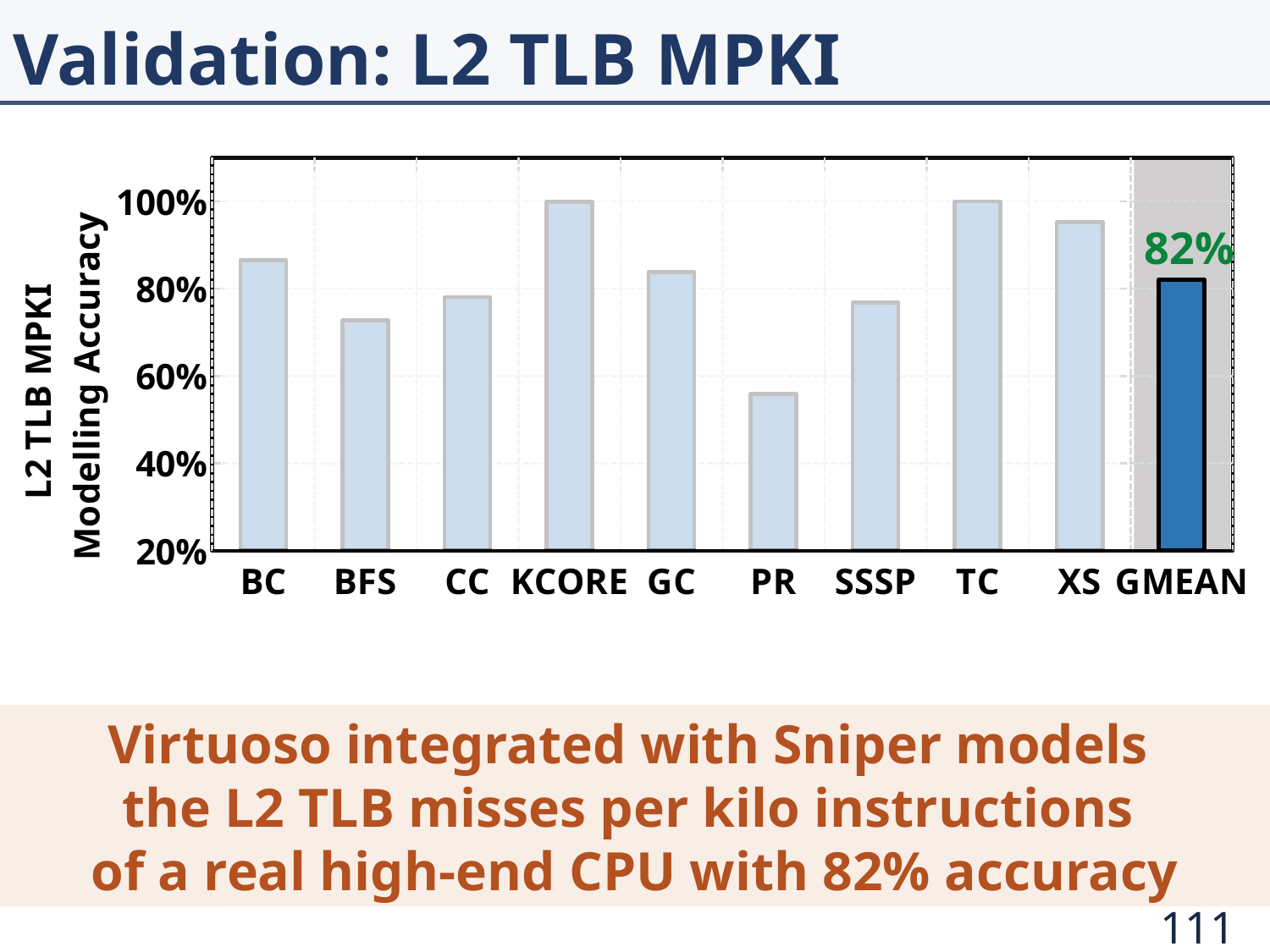
Which has a higher value, PR or SSSP? SSSP Is the value for BC greater or less than 80%? greater Is the value for XS greater or less than 80%? greater What is the label of the y axis? L2 TLB MPKI Modelling Accuracy Is the value for PR greater or less than 60%? less What is the value shown for GMEAN? 82% How many categories are shown on the x axis? 10 Which category has the lowest L2 TLB MPKI modelling accuracy? PR Which has a higher value, BC or BFS? BC What kind of chart is shown on the slide? bar chart Which has a higher value, XS or GC? XS